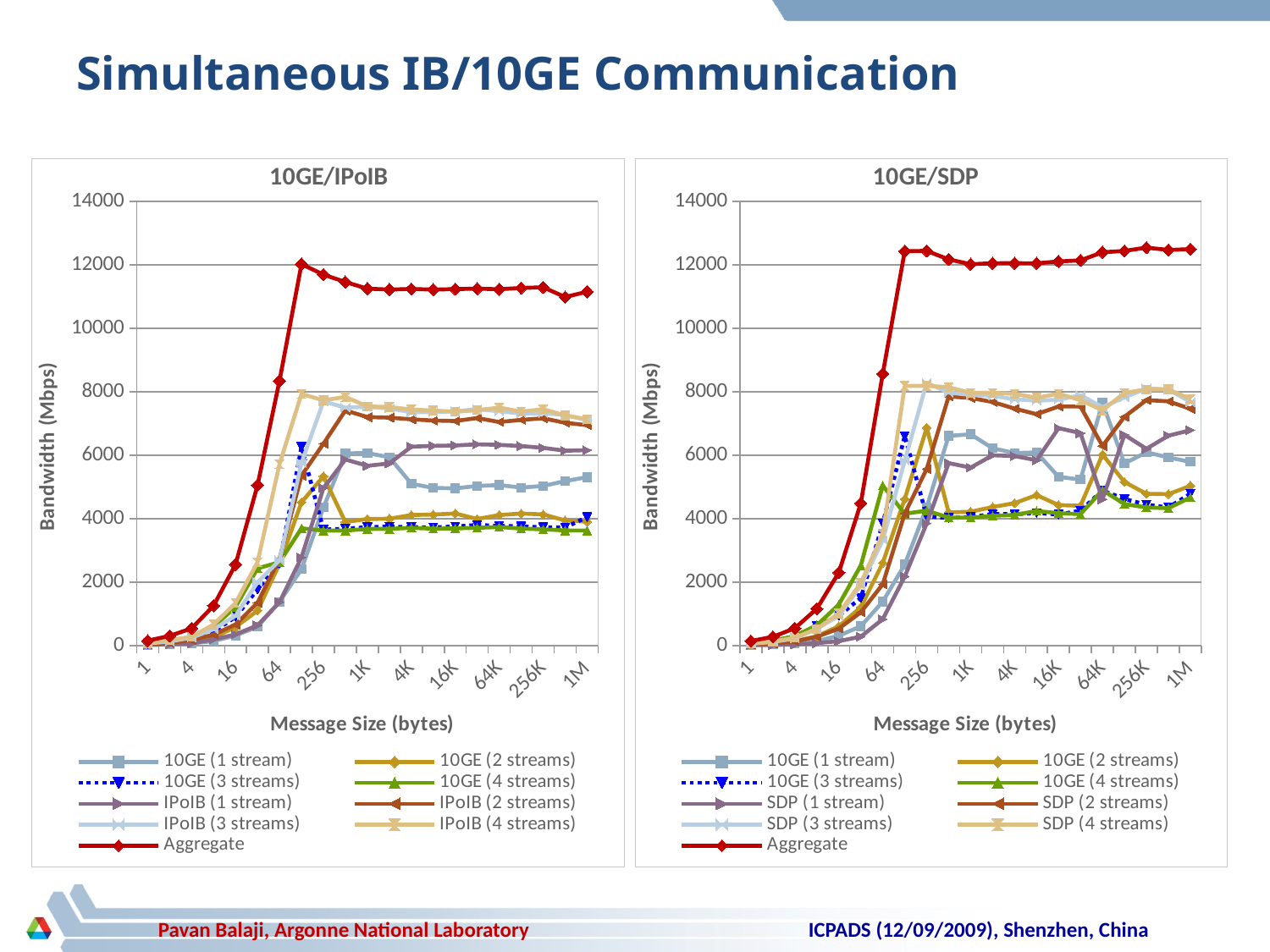
In the 10GE/IPoIB chart, is the 10GE (4 streams) value at 1M greater or less than 4000? less In the 10GE/IPoIB chart, is the IPoIB (4 streams) value at 1M greater or less than 6000? greater In the 10GE/IPoIB chart, does the Aggregate series rise or fall as message size increases from 1 to 256 bytes? rise In the 10GE/SDP chart, is the SDP (4 streams) value at 1M greater or less than 6000? greater How many series does the legend of the 10GE/SDP chart list? 9 How many message size labels are shown on the x axis of the 10GE/SDP chart? 11 At a message size of 1M, is the Aggregate bandwidth larger in the 10GE/SDP chart or the 10GE/IPoIB chart? 10GE/SDP What type of chart is the 10GE/IPoIB chart? line chart What is the y-axis title of the 10GE/IPoIB chart? Bandwidth (Mbps) In the 10GE/IPoIB chart, which series has the highest bandwidth at a message size of 1M? Aggregate